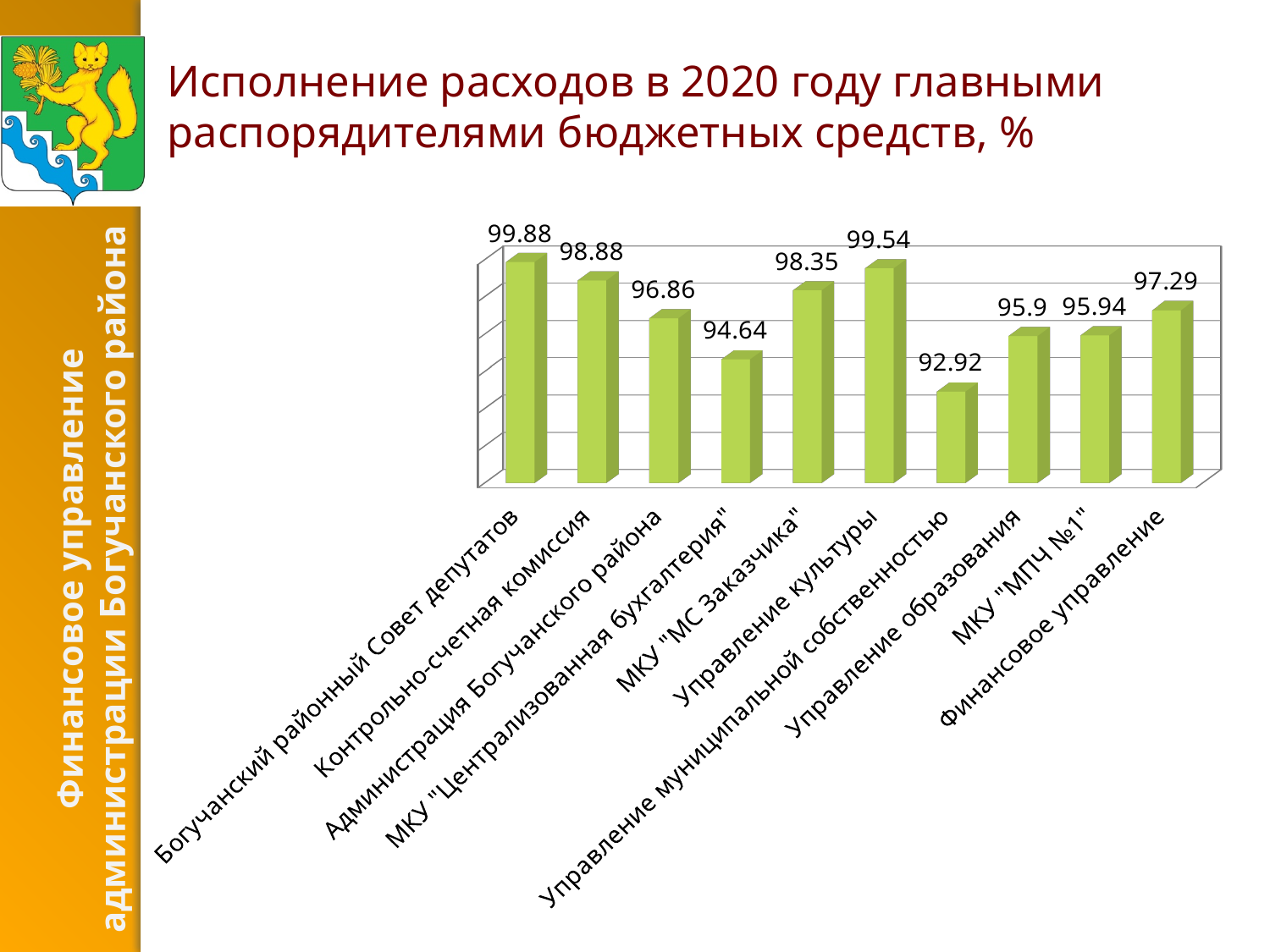
Which category has the highest value? Богучанский районный Совет депутатов How many categories are shown in the chart? 10 What is the value for Богучанский районный Совет депутатов? 99.88 Which category has the lowest value? Управление муниципальной собственностью What is the difference between the values for Финансовое управление and Управление образования? 1.39 What is the difference between the highest value (99.88) and the lowest value (92.92)? 6.96 Which is larger: the value for Управление культуры or the value for Контрольно-счетная комиссия? Управление культуры What is the value for Финансовое управление? 97.29 What is the title of the slide? Исполнение расходов в 2020 году главными распорядителями бюджетных средств, % What is the value for МКУ "Централизованная бухгалтерия"? 94.64 What is the value for Управление муниципальной собственностью? 92.92 What kind of chart is shown on the slide? Bar chart